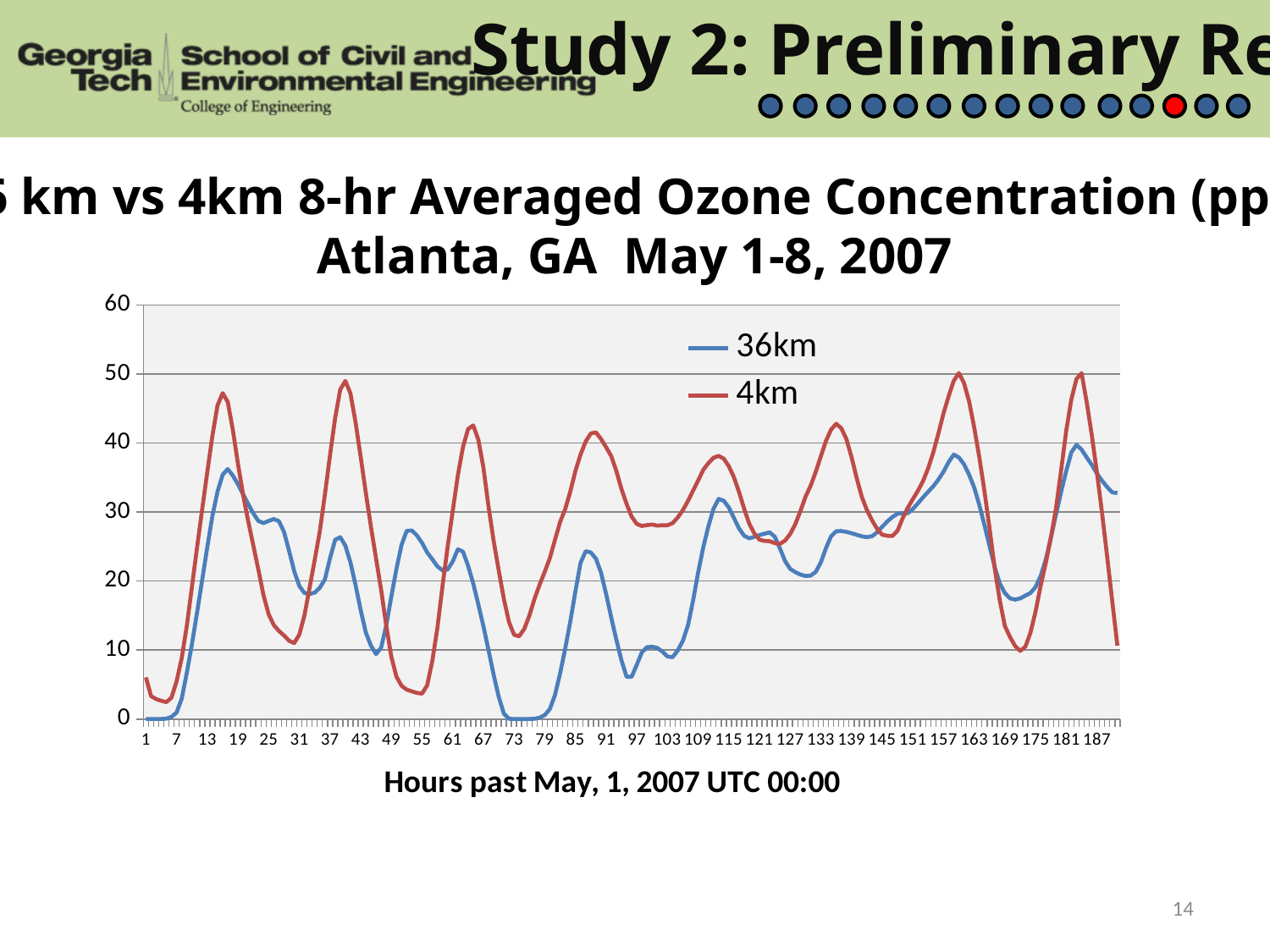
How many series does the legend list? 2 What kind of chart is shown on the slide? line chart Around hour 55, which series has the higher value, 36km or 4km? 36km Around hour 16, is the value of the 36km series greater or less than 40? less Around hour 73, is the value of the 4km series greater or less than 20? less Around hour 160, is the value of the 4km series greater or less than 40? greater Around hour 16, which series has the higher value, 36km or 4km? 4km Around hour 91, which series has the higher value, 36km or 4km? 4km Which two series are listed in the chart legend? 36km and 4km What is the x-axis title of the chart? Hours past May, 1, 2007 UTC 00:00